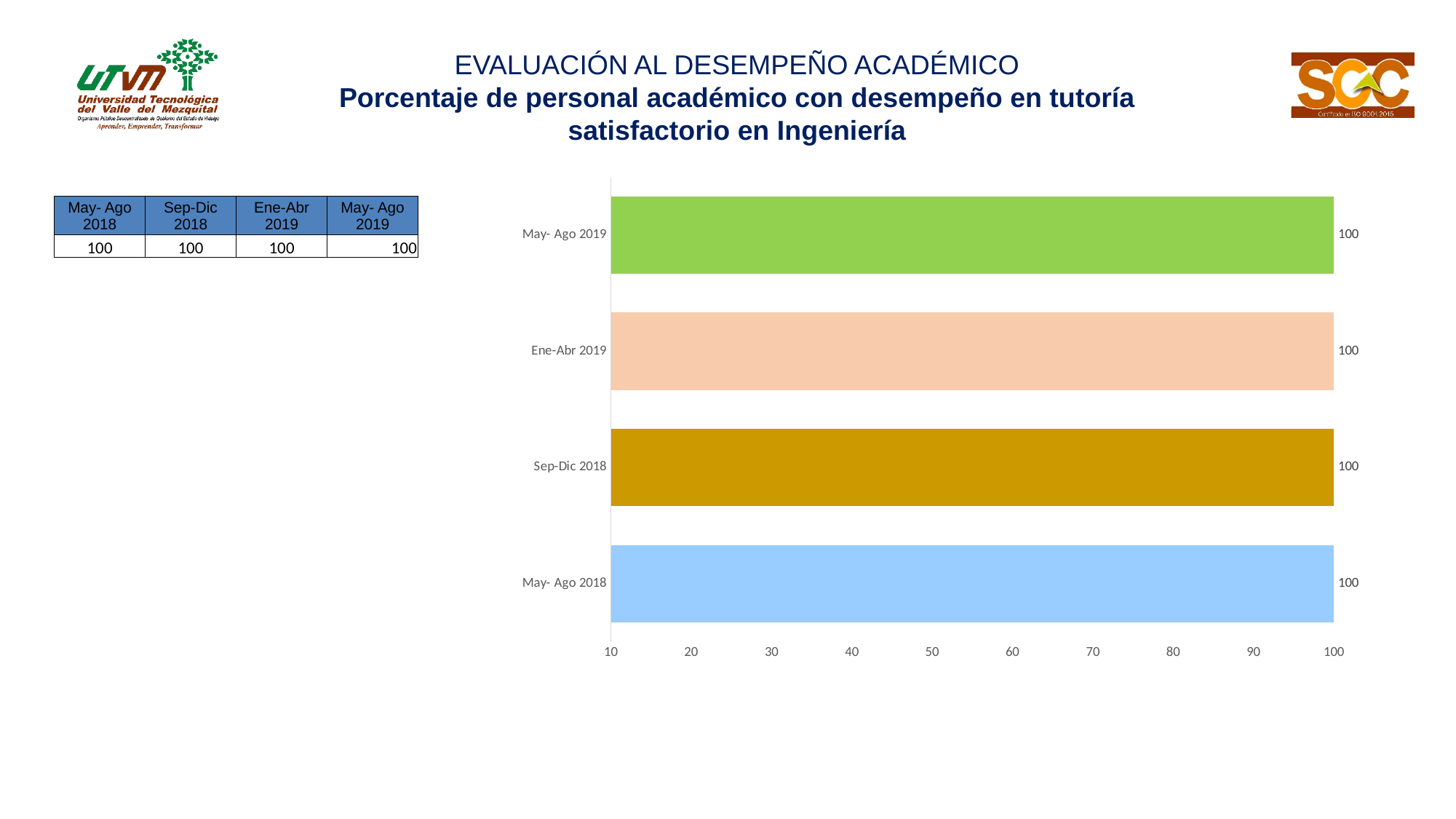
Is the value for Sep-Dic 2018 greater or less than 90? greater What is the highest tick value shown on the horizontal axis? 100 What is the value for May- Ago 2019? 100 Do the values change across the four periods shown in the chart? No, they stay constant at 100 What is the value for Sep-Dic 2018? 100 What is the value for Ene-Abr 2019? 100 What is the value for May- Ago 2018? 100 What kind of chart is shown on the slide? bar chart How many categories (periods) are shown in the chart? 4 What is the difference between the values for May- Ago 2019 and May- Ago 2018? 0 What colour is the bar for Sep-Dic 2018? Dark yellow (gold)